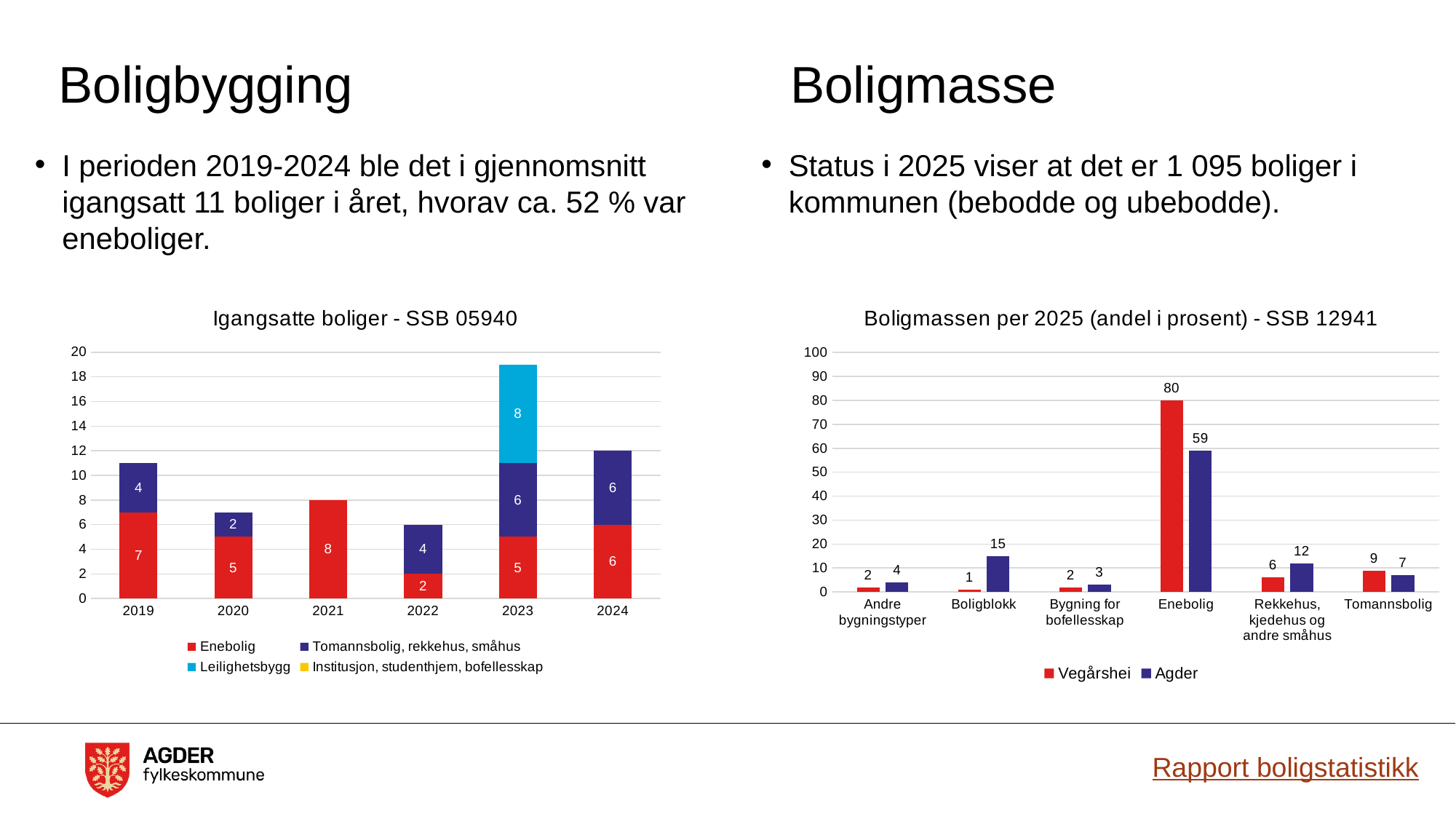
In the chart 'Boligmassen per 2025 (andel i prosent) - SSB 12941', which is larger for Tomannsbolig, Vegårshei or Agder? Vegårshei In the chart 'Boligmassen per 2025 (andel i prosent) - SSB 12941', what is the Agder value for Boligblokk? 15 In the chart 'Boligmassen per 2025 (andel i prosent) - SSB 12941', what is the difference between the Vegårshei and Agder values for Enebolig? 21 In the chart 'Igangsatte boliger - SSB 05940', what is the difference between the Enebolig values for 2019 and 2022? 5 In the chart 'Igangsatte boliger - SSB 05940', what is the Enebolig value for 2021? 8 In the chart 'Igangsatte boliger - SSB 05940', what is the total of the stacked bar for 2019? 11 What kind of chart is 'Boligmassen per 2025 (andel i prosent) - SSB 12941'? Bar chart In the chart 'Igangsatte boliger - SSB 05940', what is the Leilighetsbygg value for 2023? 8 In the chart 'Igangsatte boliger - SSB 05940', how many series does the legend list? 4 In the chart 'Igangsatte boliger - SSB 05940', what is the total of the stacked bar for 2023? 19 In the chart 'Boligmassen per 2025 (andel i prosent) - SSB 12941', which category has the highest Vegårshei value? Enebolig In the chart 'Igangsatte boliger - SSB 05940', how many years are shown on the x axis? 6